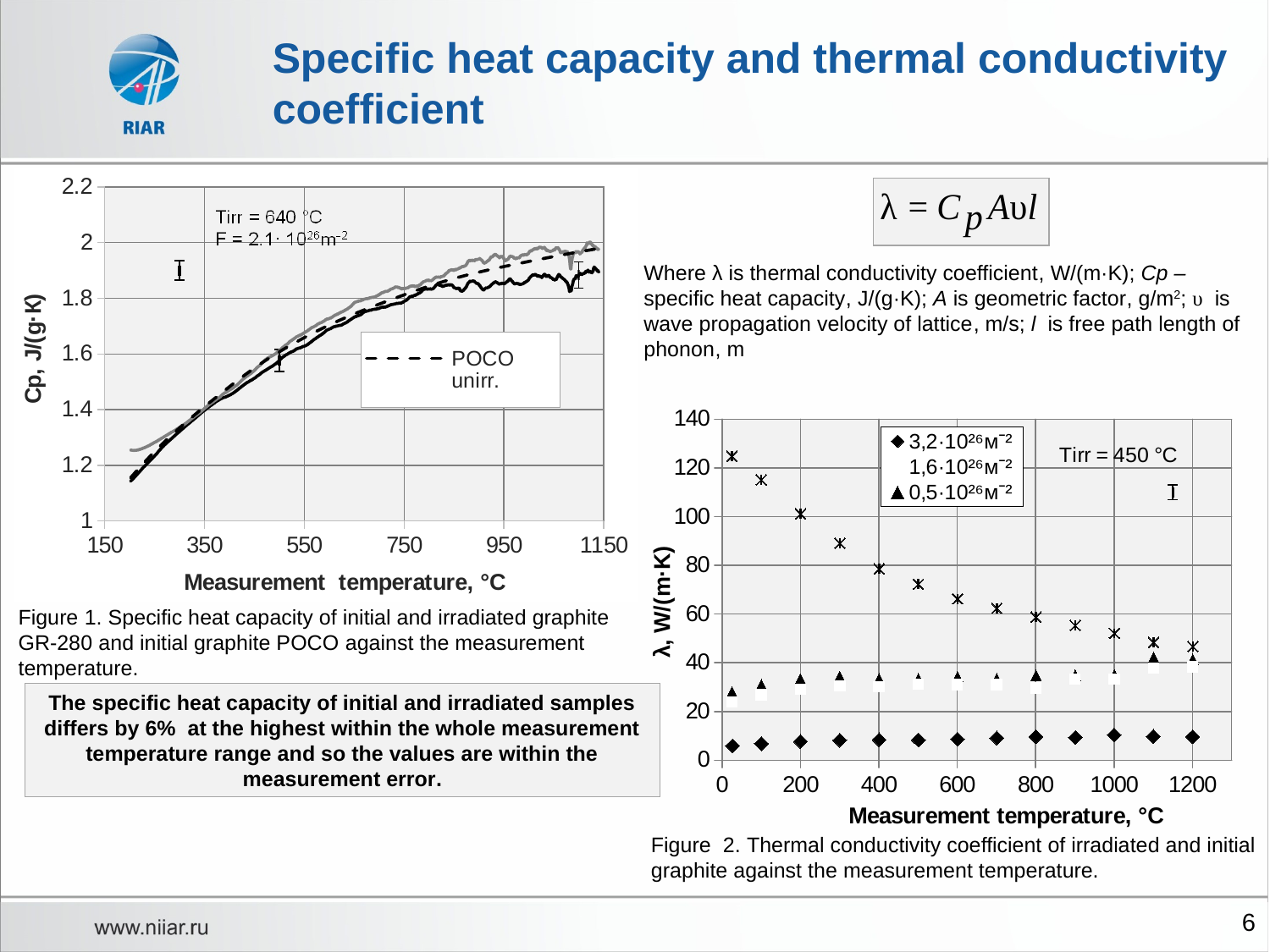
In Figure 2, is the value for the 1,6·10²⁶м⁻² series at 1200 °C greater or less than 60 W/(m·K)? less In Figure 2, how many series does the legend list? 3 In Figure 1, is the specific heat capacity at 350 °C greater or less than 1.6 J/(g·K)? less What kind of chart is Figure 1 (the left chart)? line chart In Figure 2, at 200 °C, which series has the larger value: 0,5·10²⁶м⁻² or 3,2·10²⁶м⁻²? 0,5·10²⁶м⁻² In Figure 2, which of the legend series has the lowest thermal conductivity values across the temperature range? 3,2·10²⁶м⁻² In Figure 2, what irradiation temperature (Tirr) is stated on the chart? 450 °C In Figure 1, does the specific heat capacity rise or fall as the measurement temperature increases? rises What kind of chart is Figure 2 (the right chart)? scatter chart In Figure 2, is the value for the 3,2·10²⁶м⁻² series at 1200 °C greater or less than 20 W/(m·K)? less In Figure 1, what series is named in the legend? POCO unirr.